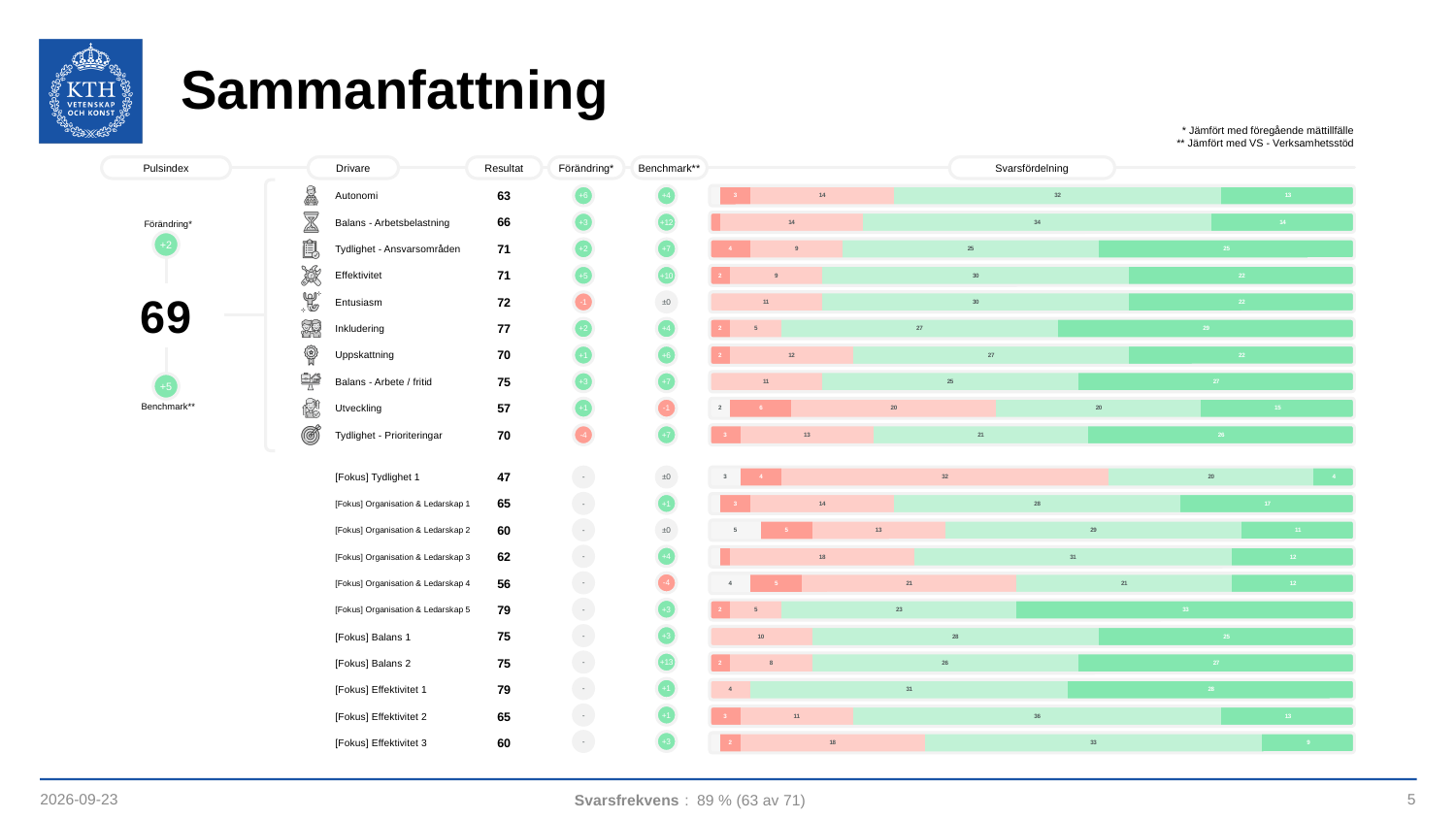
What is the Benchmark** value shown for Balans - Arbetsbelastning? +12 Among the Drivare rows (Autonomi through Tydlighet - Prioriteringar), which has the highest Resultat? Inkludering Among the Drivare rows (Autonomi through Tydlighet - Prioriteringar), which has the lowest Resultat? Utveckling What is the difference in Resultat between Inkludering and Utveckling? 20 What is the Resultat value for Inkludering? 77 In the Svarsfördelning bar for Effektivitet, what is the total of the labelled segments (2, 9, 30, 22)? 63 What is the overall Pulsindex shown on the slide? 69 How many Drivare rows are listed above the [Fokus] rows? 10 What is the Resultat value for Utveckling? 57 Which has a higher Resultat, Entusiasm or Autonomi? Entusiasm What is the Resultat value for [Fokus] Tydlighet 1? 47 What kind of chart is used in the Svarsfördelning column? Stacked bar chart